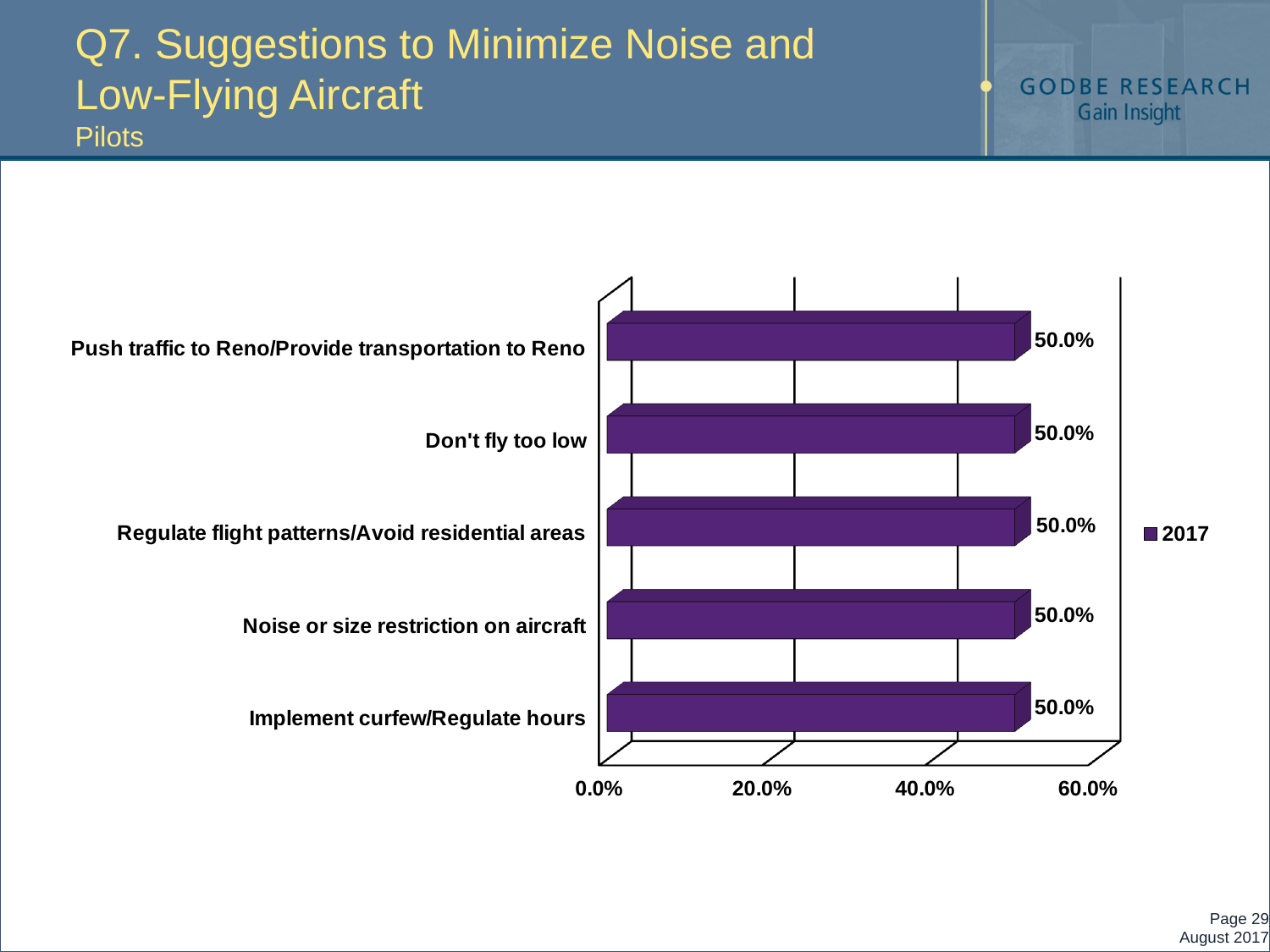
How many categories are shown in the chart? 5 What is the value for "Noise or size restriction on aircraft"? 50.0% Is the value for "Implement curfew/Regulate hours" greater or less than 60.0%? less What is the value for "Implement curfew/Regulate hours"? 50.0% How many series does the legend list? 1 What is the highest value shown on the x axis? 60.0% What is the value for "Don't fly too low"? 50.0% What series name is shown in the legend? 2017 What is the value for "Push traffic to Reno/Provide transportation to Reno"? 50.0% What is the difference between the values for "Regulate flight patterns/Avoid residential areas" and "Don't fly too low"? 0.0% Is the value for "Regulate flight patterns/Avoid residential areas" greater or less than 40.0%? greater What kind of chart is shown on the slide? Bar chart